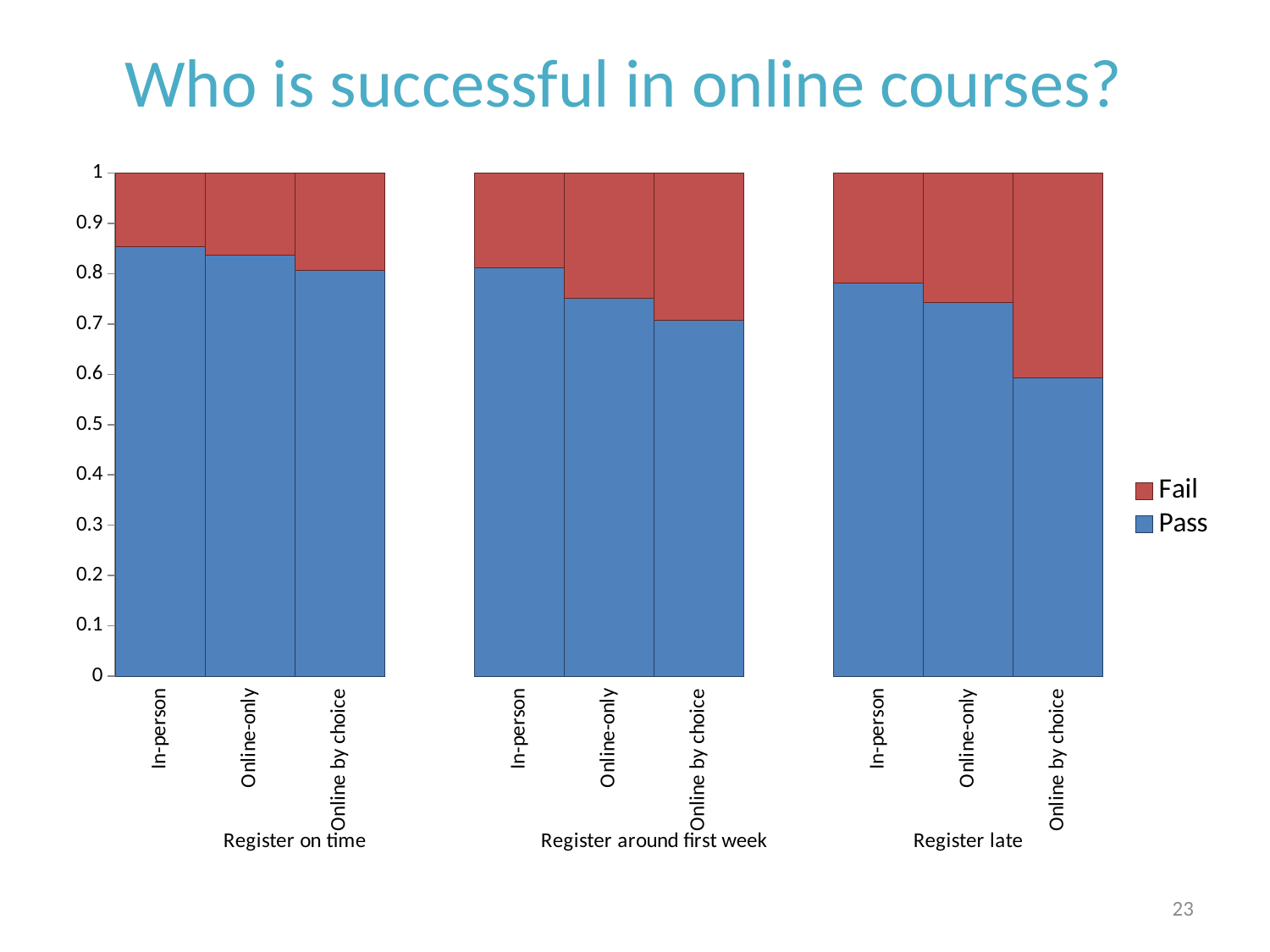
Which bar has the largest Fail share? Online by choice in the Register late group How many series does the legend list? 2 What is the total height of each stacked bar? 1 What kind of chart is shown on the slide? Stacked bar chart Is the Pass value for Online by choice students who register late greater or less than 0.7? less Which is larger: the Pass share for In-person students who register on time or for In-person students who register late? In-person students who register on time What are the two series named in the legend? Fail and Pass How many bars are plotted in the chart in total? 9 Which bar has the lowest Pass share? Online by choice in the Register late group Within the Register late group, does the Pass share rise or fall from In-person to Online by choice? Fall Is the Pass value for In-person students who register on time greater or less than 0.8? greater How many registration groups are shown along the x axis? 3